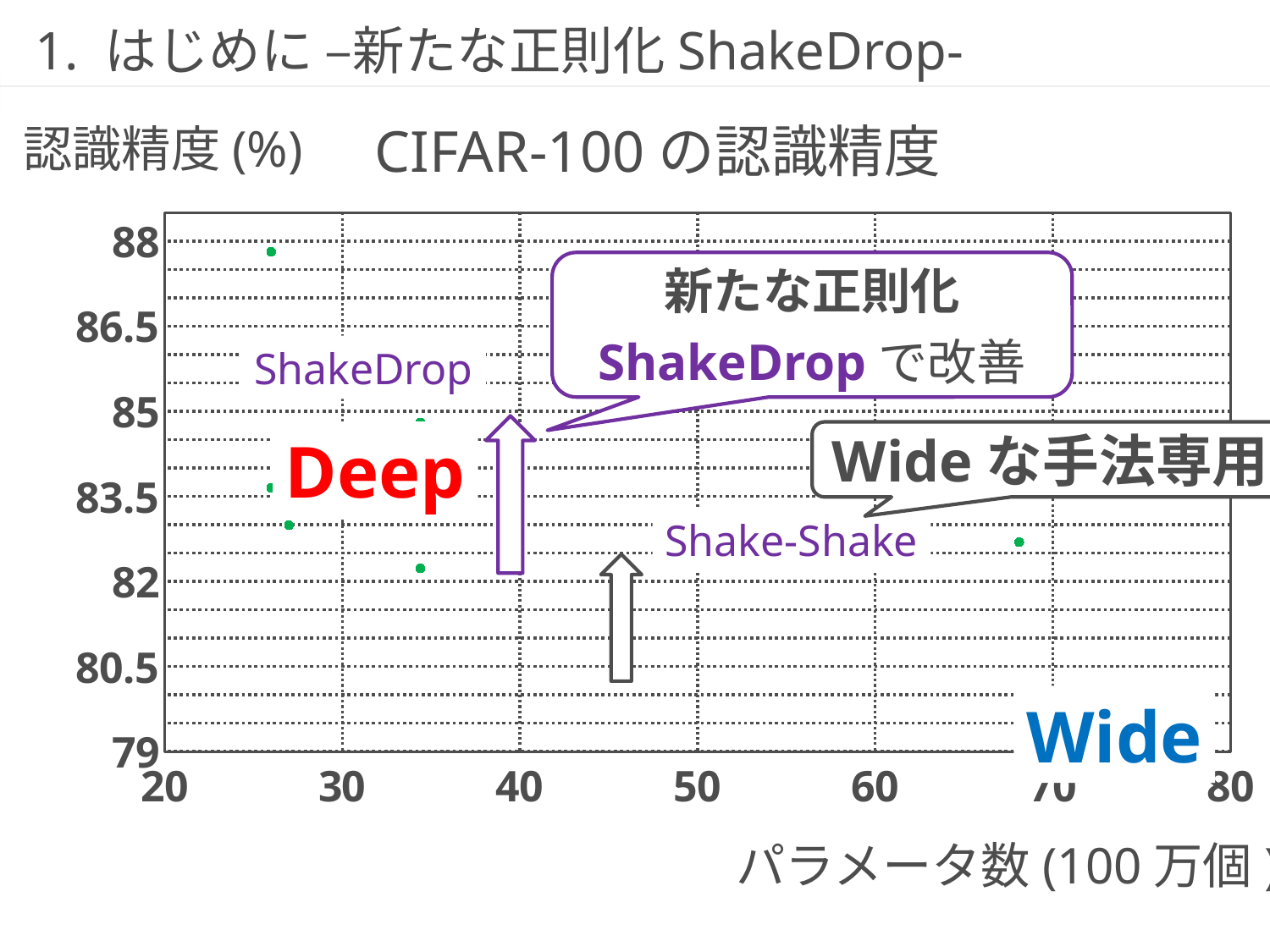
Is the value of the highest point on the chart greater or less than 88? less Is the value of the point plotted near 70 on the x axis greater or less than 82? greater Is the value of the highest point on the chart greater or less than 86.5? greater What is the label of the vertical axis? 認識精度 (%) What is the highest value shown on the horizontal axis? 80 Which is larger: the value of the highest point near 26 on the x axis, or the value of the point near 70 on the x axis? the point near 26 What kind of chart is shown on the slide? scatter chart What is the lowest value shown on the vertical axis? 79